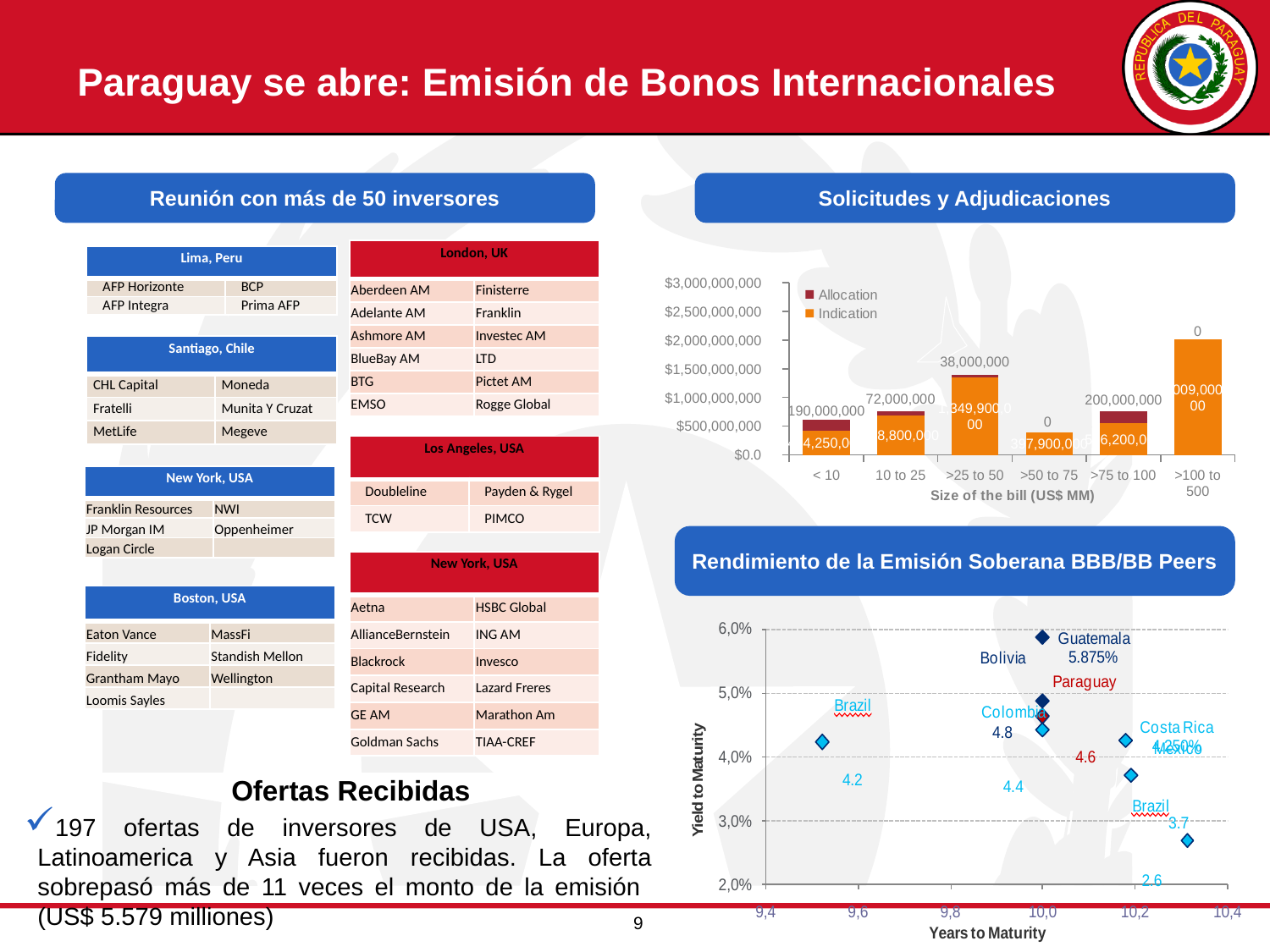
In the 'Solicitudes y Adjudicaciones' chart, which bar is taller: '>25 to 50' or '10 to 25'? >25 to 50 In the 'Solicitudes y Adjudicaciones' chart, which bill-size category has the tallest bar? >100 to 500 In the 'Rendimiento de la Emisión Soberana BBB/BB Peers' chart, what yield is labeled for Guatemala? 5.875% In the 'Solicitudes y Adjudicaciones' chart, is the total bar for '< 10' greater or less than $1,000,000,000? less In the 'Solicitudes y Adjudicaciones' chart, is the total bar for '>100 to 500' greater or less than $1,500,000,000? greater What kind of chart is the 'Rendimiento de la Emisión Soberana BBB/BB Peers' chart? scatter chart How many bill-size categories are shown on the x axis of the 'Solicitudes y Adjudicaciones' chart? 6 What kind of chart is the 'Solicitudes y Adjudicaciones' chart? bar chart In the 'Solicitudes y Adjudicaciones' chart, what is the Allocation value labeled for the '10 to 25' category? 72,000,000 How many series does the legend of the 'Solicitudes y Adjudicaciones' chart list? 2 In the 'Solicitudes y Adjudicaciones' chart, what is the Allocation value labeled for the '>50 to 75' category? 0 In the 'Solicitudes y Adjudicaciones' chart, what is the Allocation value labeled for the '>75 to 100' category? 200,000,000